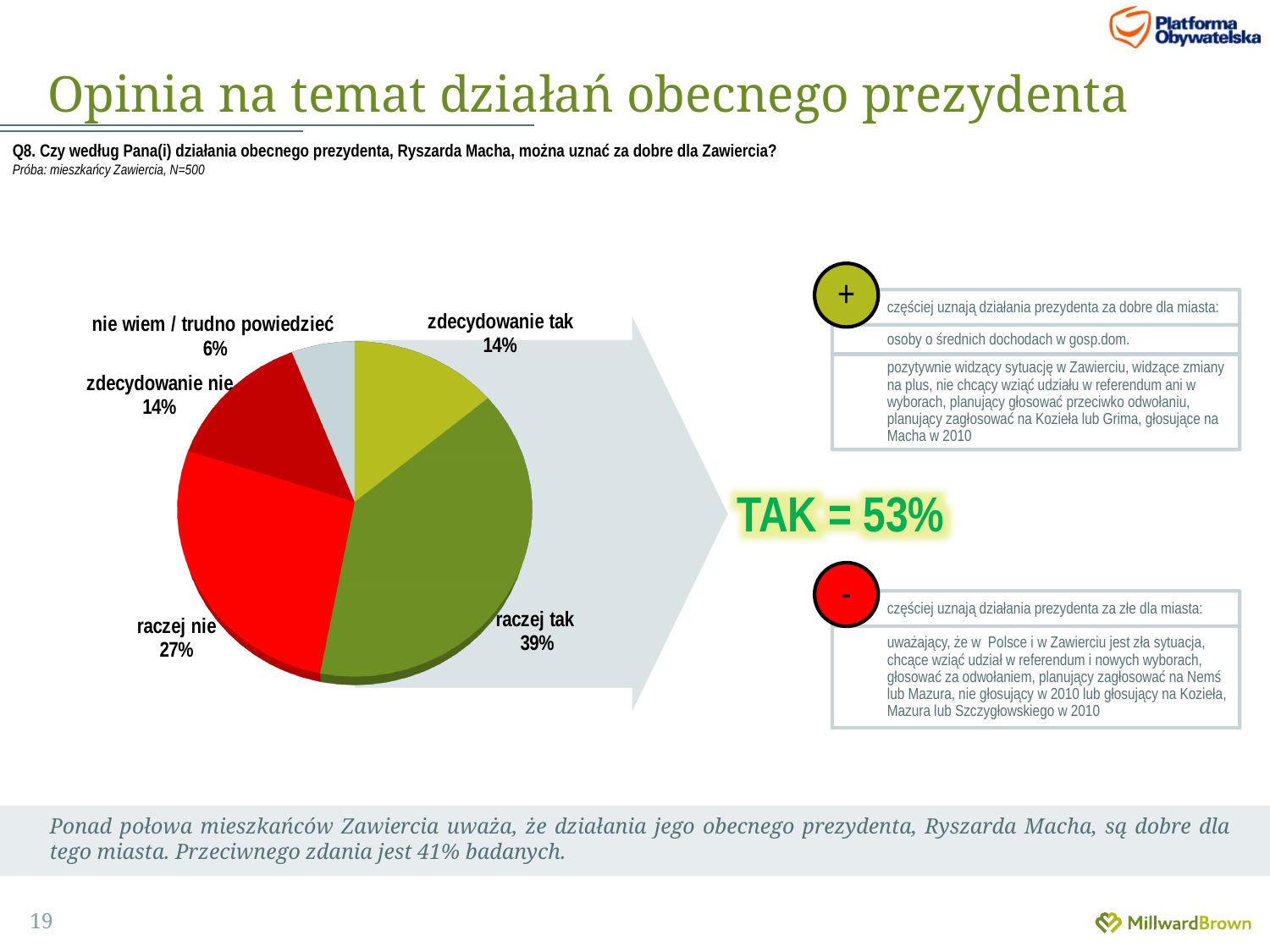
Which answer category has the largest share of the pie? raczej tak What percentage of respondents answered "nie wiem / trudno powiedzieć"? 6% What is the combined share of "zdecydowanie tak" and "raczej tak" as stated on the slide? 53% Which answer category has the smallest share of the pie? nie wiem / trudno powiedzieć How many slices does the pie chart have? 5 What percentage of respondents answered "zdecydowanie tak"? 14% What percentage of respondents answered "raczej tak"? 39% What percentage of respondents answered "raczej nie"? 27% What is the difference in percentage points between "raczej tak" and "raczej nie"? 12 What kind of chart is shown on the slide? pie chart What colour is the "raczej nie" slice of the pie chart? red Which is larger: the share for "raczej nie" or the share for "zdecydowanie nie"? raczej nie